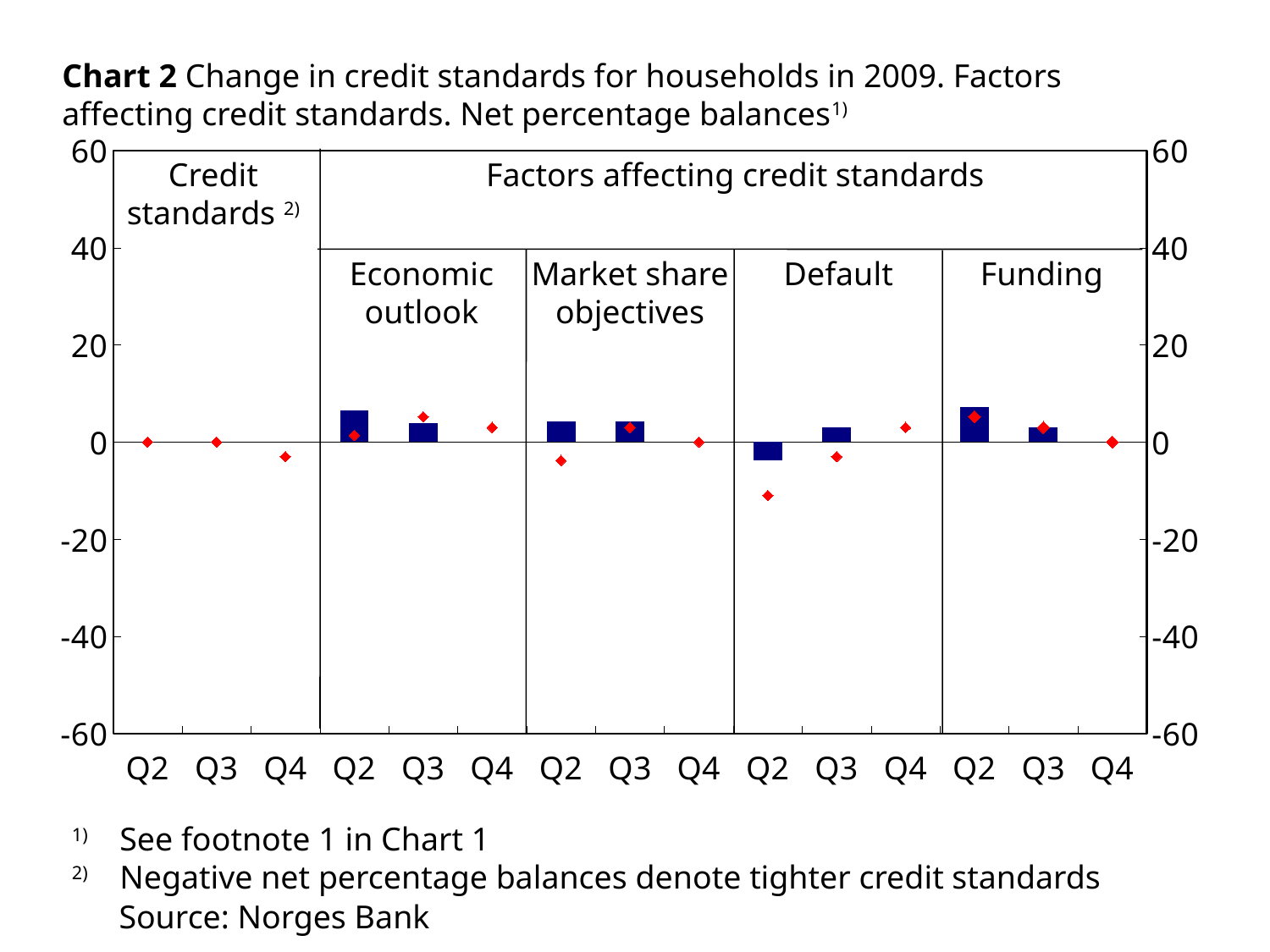
What kind of chart is shown on the slide? combination bar and line chart (bars with red diamond markers) Is the red diamond marker for Q2 in the Default panel greater or less than -20? greater What are the minimum and maximum values shown on the chart's vertical axis? -60 and 60 How many factors affecting credit standards are shown as separate panels in the chart? 4 How many quarters are shown on the x axis within each panel of the chart? 3 Is the red diamond marker for Q2 in the Default panel greater or less than 0? less Is the bar for Q2 in the Economic outlook panel greater or less than 20? less Which is larger: the bar for Q2 in the Funding panel or the bar for Q2 in the Default panel? Funding Q2 In which panel and quarter is the lowest red diamond marker in the chart? Default, Q2 What is the heading above the four right-hand panels of the chart? Factors affecting credit standards